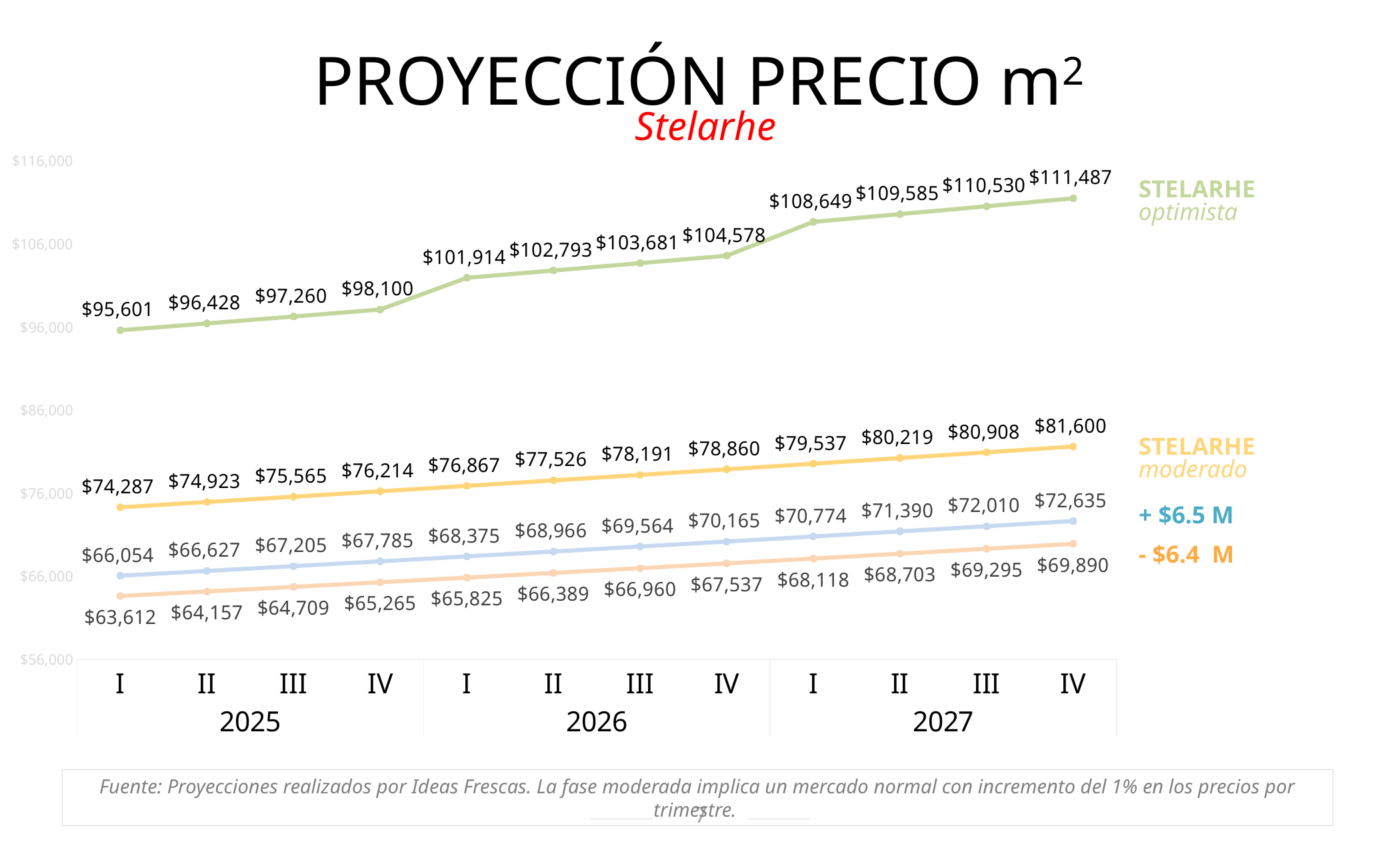
Which is larger in quarter I of 2026: the STELARHE moderado value or the + $6.5 M value? STELARHE moderado What kind of chart is shown on the slide? line chart What is the title of the chart? PROYECCIÓN PRECIO m² Stelarhe How many quarters are plotted along the x axis? 12 Do the values of the STELARHE optimista series rise or fall from 2025 to 2027? rise What is the lowest value shown for the - $6.4 M series? $63,612 What is the value of the STELARHE optimista series in quarter IV of 2027? $111,487 What is the value of the - $6.4 M series in quarter III of 2027? $69,295 In which quarter does the STELARHE optimista series reach its highest value? IV 2027 What is the difference between the STELARHE optimista and STELARHE moderado values in quarter IV of 2027? $29,887 What is the value of the + $6.5 M series in quarter II of 2026? $68,966 What is the value of the STELARHE moderado series in quarter I of 2025? $74,287